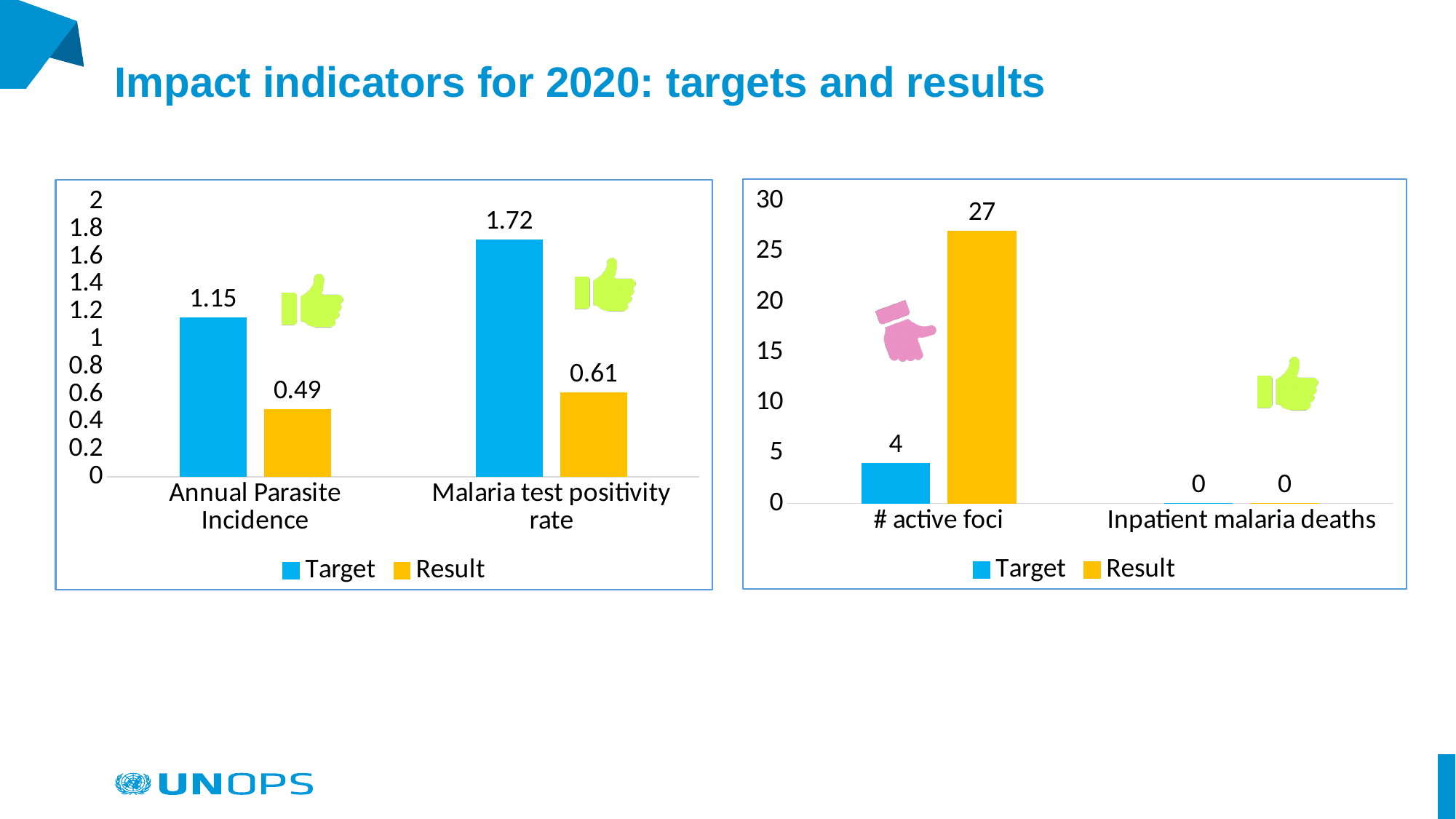
What type of chart is the left chart? Bar chart In the left chart, what is the Target value for Annual Parasite Incidence? 1.15 In the left chart, what colour are the Result bars? Orange In the left chart, which is larger for Malaria test positivity rate, the Target or the Result? Target In the left chart, what is the difference between the Target and Result values for Annual Parasite Incidence? 0.66 In the left chart, which bar has the highest value? Target for Malaria test positivity rate In the right chart, which is larger for # active foci, the Target or the Result? Result In the right chart, what is the Target value for Inpatient malaria deaths? 0 In the left chart, what is the Result value for Malaria test positivity rate? 0.61 In the right chart, what is the difference between the Result and Target values for # active foci? 23 In the right chart, what is the Result value for # active foci? 27 How many series does the legend of the right chart list? 2